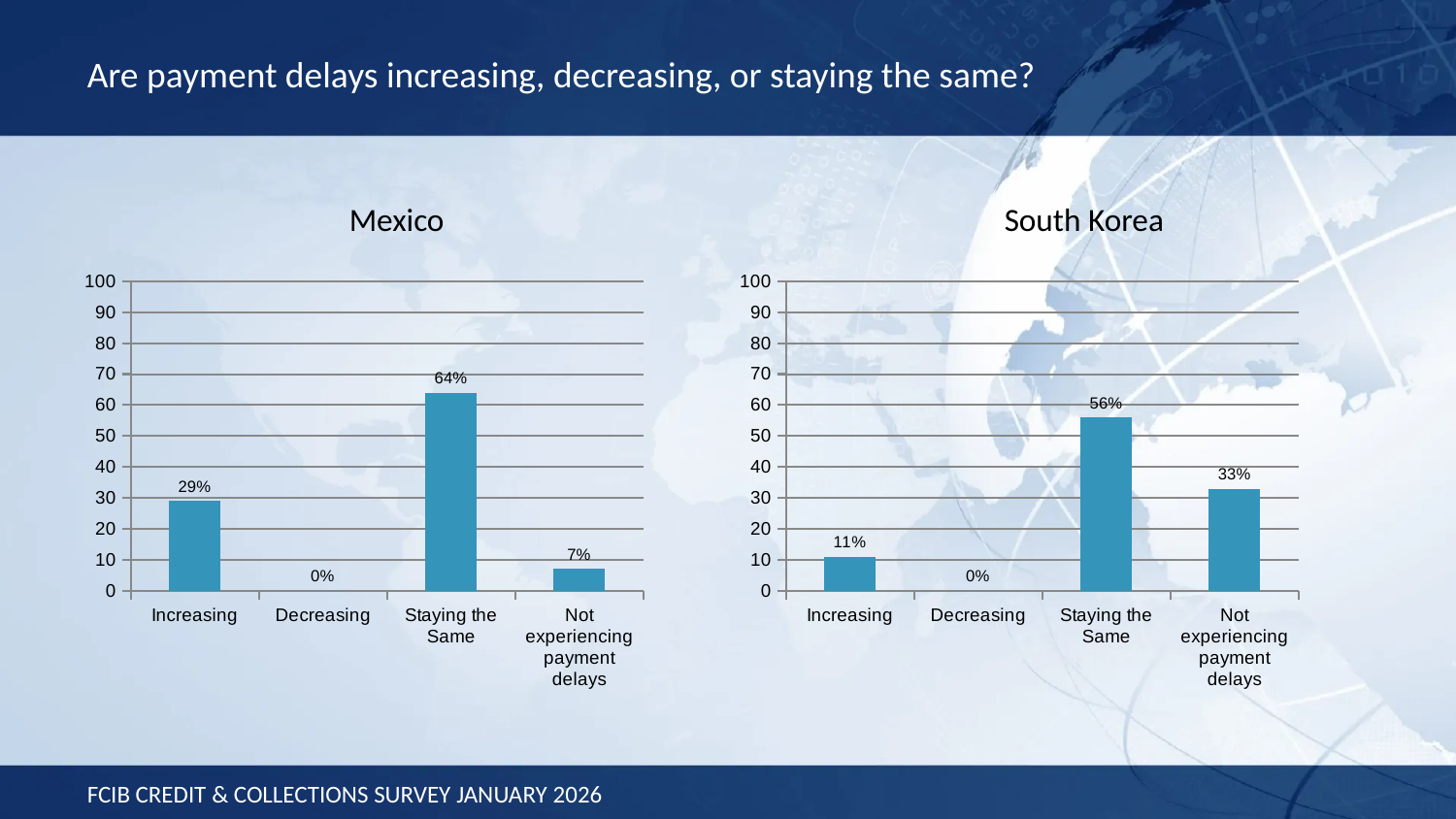
In the Mexico chart, what is the difference between Staying the Same and Increasing? 35% In the Mexico chart, what is the value for Staying the Same? 64% In the South Korea chart, what is the value for Increasing? 11% What is the title of the chart on the right side of the slide? South Korea Which is larger: Increasing in the Mexico chart or Increasing in the South Korea chart? Mexico What kind of chart is the Mexico chart? bar chart In the South Korea chart, what is the difference between Staying the Same and Not experiencing payment delays? 23% How many categories are shown in the South Korea chart? 4 In the Mexico chart, is the value for Staying the Same greater or less than 50? greater In the South Korea chart, which category has the lowest value? Decreasing In the South Korea chart, what is the value for Not experiencing payment delays? 33% In the Mexico chart, which category has the highest value? Staying the Same